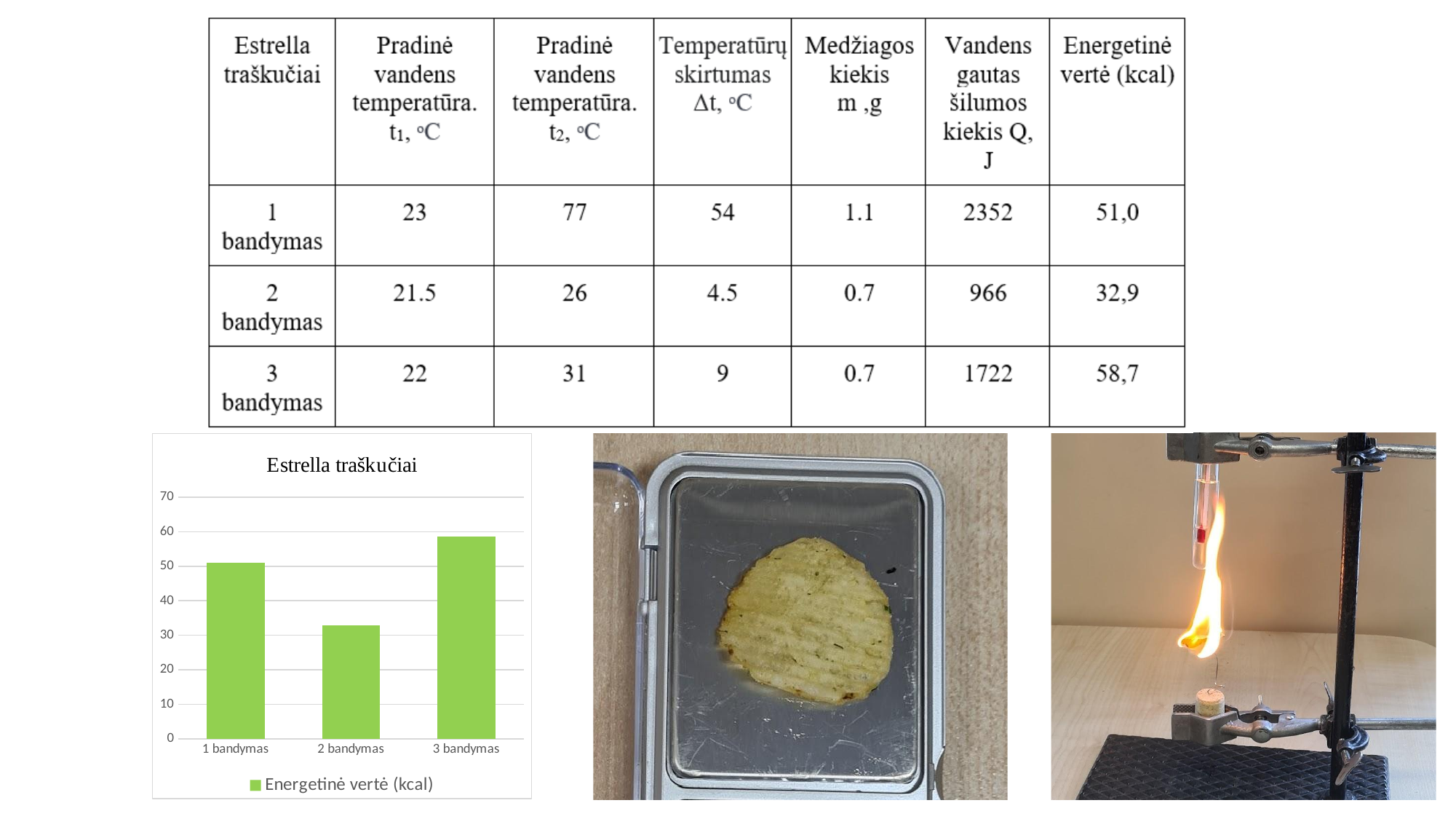
How many series does the chart legend list? 1 Which is larger in the chart, the value for 1 bandymas or 2 bandymas? 1 bandymas Is the value for 2 bandymas greater or less than 40? less Is the value for 1 bandymas greater or less than 50? greater How many bars (bandymai) does the chart show? 3 Is the value for 3 bandymas greater or less than 60? less Which bandymas has the lowest energetinė vertė in the chart? 2 bandymas What is the title of the chart? Estrella traškučiai According to the table on the slide, what is the energetinė vertė (kcal) for 3 bandymas? 58,7 What kind of chart is shown on the slide? bar chart What series name is shown in the chart legend? Energetinė vertė (kcal) Which bandymas has the highest energetinė vertė in the chart? 3 bandymas